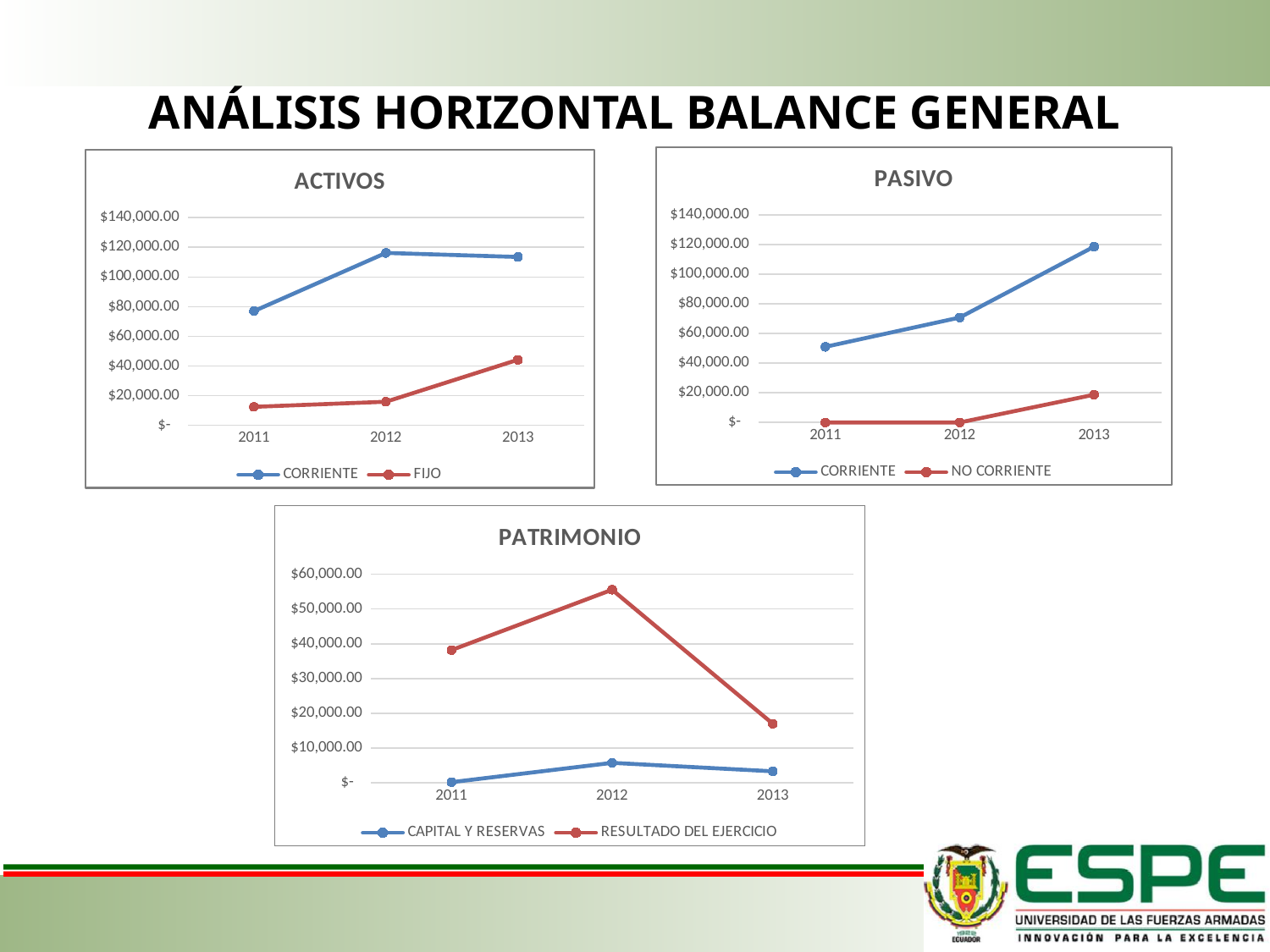
In the ACTIVOS chart, is the value for CORRIENTE in 2011 greater or less than $60,000.00? greater In the PATRIMONIO chart, is the value for RESULTADO DEL EJERCICIO in 2013 greater or less than $20,000.00? less What are the two series listed in the legend of the PATRIMONIO chart? CAPITAL Y RESERVAS and RESULTADO DEL EJERCICIO In the ACTIVOS chart, is the value for FIJO in 2013 greater or less than $60,000.00? less How many years are shown on the x axis of the PATRIMONIO chart? 3 What type of chart is the ACTIVOS chart? line chart In the PASIVO chart, which series is higher in 2012, CORRIENTE or NO CORRIENTE? CORRIENTE In the PASIVO chart, does the CORRIENTE series rise or fall from 2011 to 2013? rise How many series does the legend of the PASIVO chart list? 2 In the ACTIVOS chart, in which year is CORRIENTE at its lowest? 2011 In the PATRIMONIO chart, in which year is RESULTADO DEL EJERCICIO at its highest? 2012